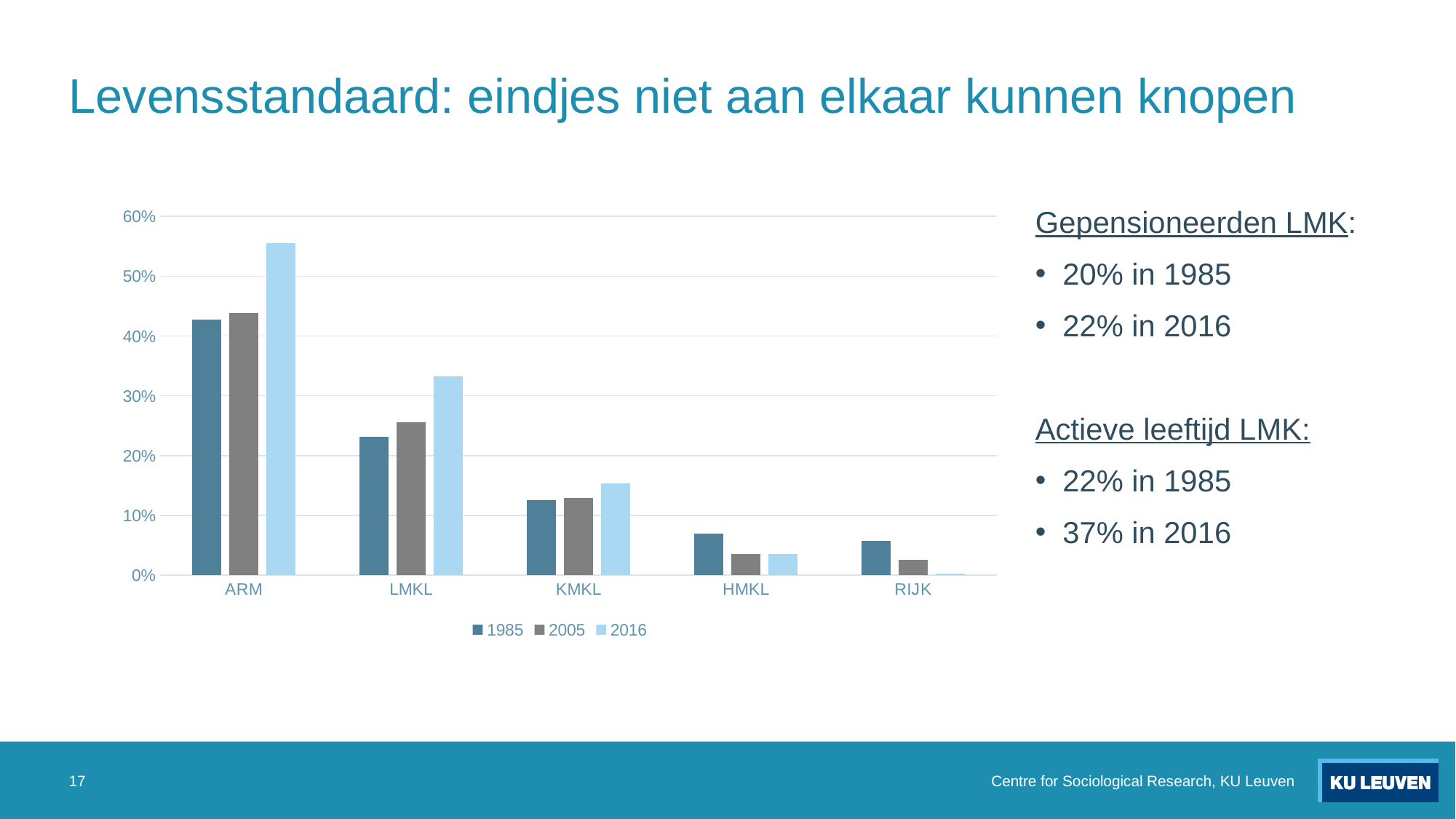
Which category has the highest value for the 2016 series? ARM How many categories are shown on the x axis of the chart? 5 Is the value for ARM in 2016 greater or less than 50%? greater How many series does the chart's legend list? 3 Is the value for LMKL in 1985 greater or less than 30%? less Do the 1985 values rise or fall moving from ARM to RIJK along the x axis? fall Which category has the lowest value for the 2016 series? RIJK Which series is shown in light blue in the chart's legend? 2016 Is the value for KMKL in 2016 greater or less than 20%? less What kind of chart is shown on the slide? bar chart Which is larger for HMKL: the 1985 value or the 2016 value? 1985 Which is larger for LMKL: the 2005 value or the 2016 value? 2016